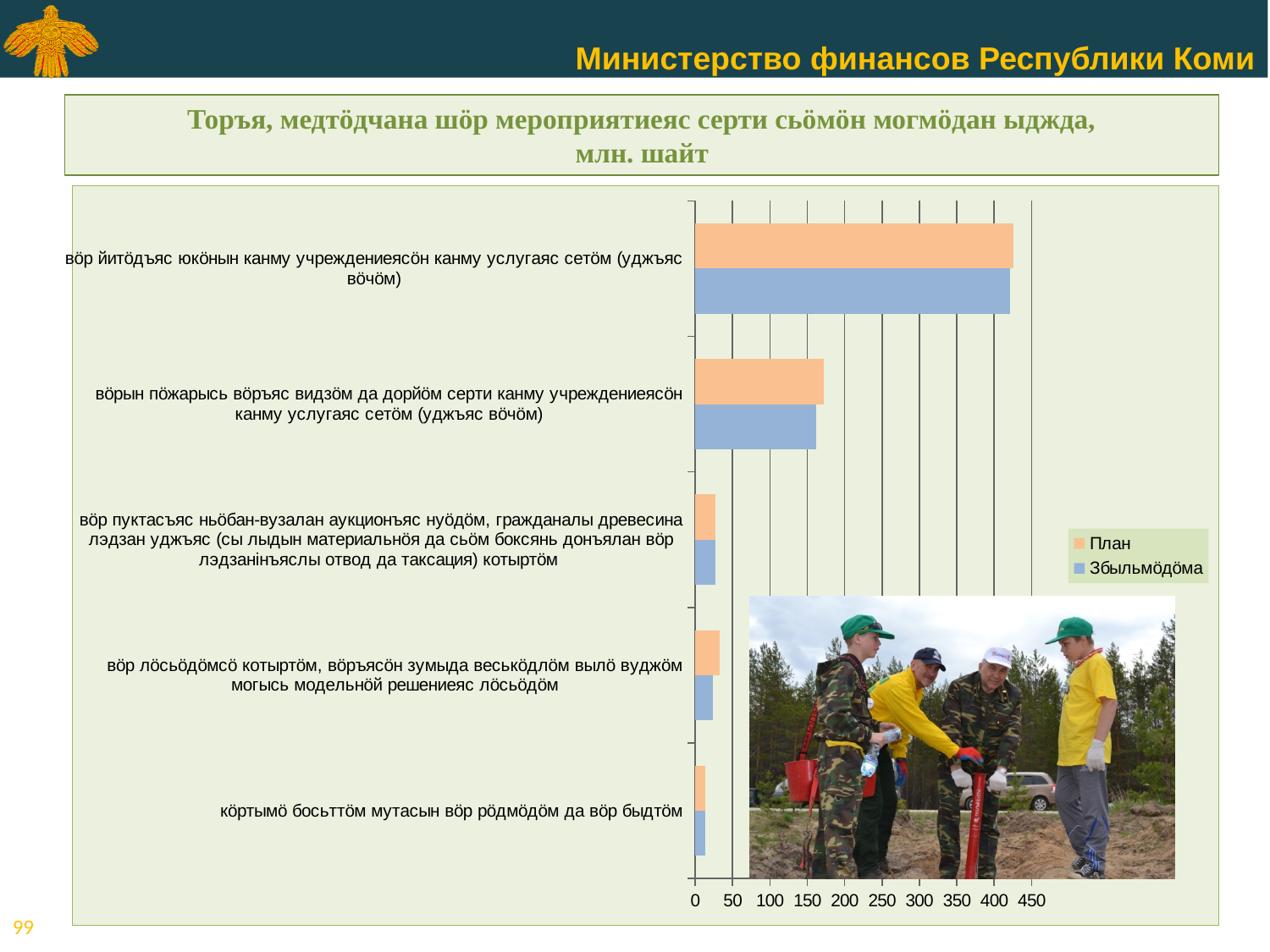
Is the Збыльмӧдӧма value for 'вӧрын пӧжарысь вӧръяс видзӧм да дорйӧм серти канму учреждениеясӧн канму услугаяс сетӧм (уджъяс вӧчӧм)' greater or less than 200? less Which category has the highest План value? вӧр йитӧдъяс юкӧнын канму учреждениеясӧн канму услугаяс сетӧм (уджъяс вӧчӧм) How many series does the legend list? 2 Which category has the lowest Збыльмӧдӧма value? кӧртымӧ босьттӧм мутасын вӧр рӧдмӧдӧм да вӧр быдтӧм What are the two series named in the legend? План and Збыльмӧдӧма Is the План value for 'вӧр йитӧдъяс юкӧнын канму учреждениеясӧн канму услугаяс сетӧм (уджъяс вӧчӧм)' greater or less than 400? greater How many categories are plotted on the chart? 5 Which colour represents the План series in the chart? orange Which has the larger План value: 'вӧр йитӧдъяс юкӧнын канму учреждениеясӧн канму услугаяс сетӧм (уджъяс вӧчӧм)' or 'вӧрын пӧжарысь вӧръяс видзӧм да дорйӧм серти канму учреждениеясӧн канму услугаяс сетӧм (уджъяс вӧчӧм)'? вӧр йитӧдъяс юкӧнын канму учреждениеясӧн канму услугаяс сетӧм (уджъяс вӧчӧм) What kind of chart is shown on the slide? bar chart Is the Збыльмӧдӧма value for 'вӧр йитӧдъяс юкӧнын канму учреждениеясӧн канму услугаяс сетӧм (уджъяс вӧчӧм)' greater or less than 350? greater